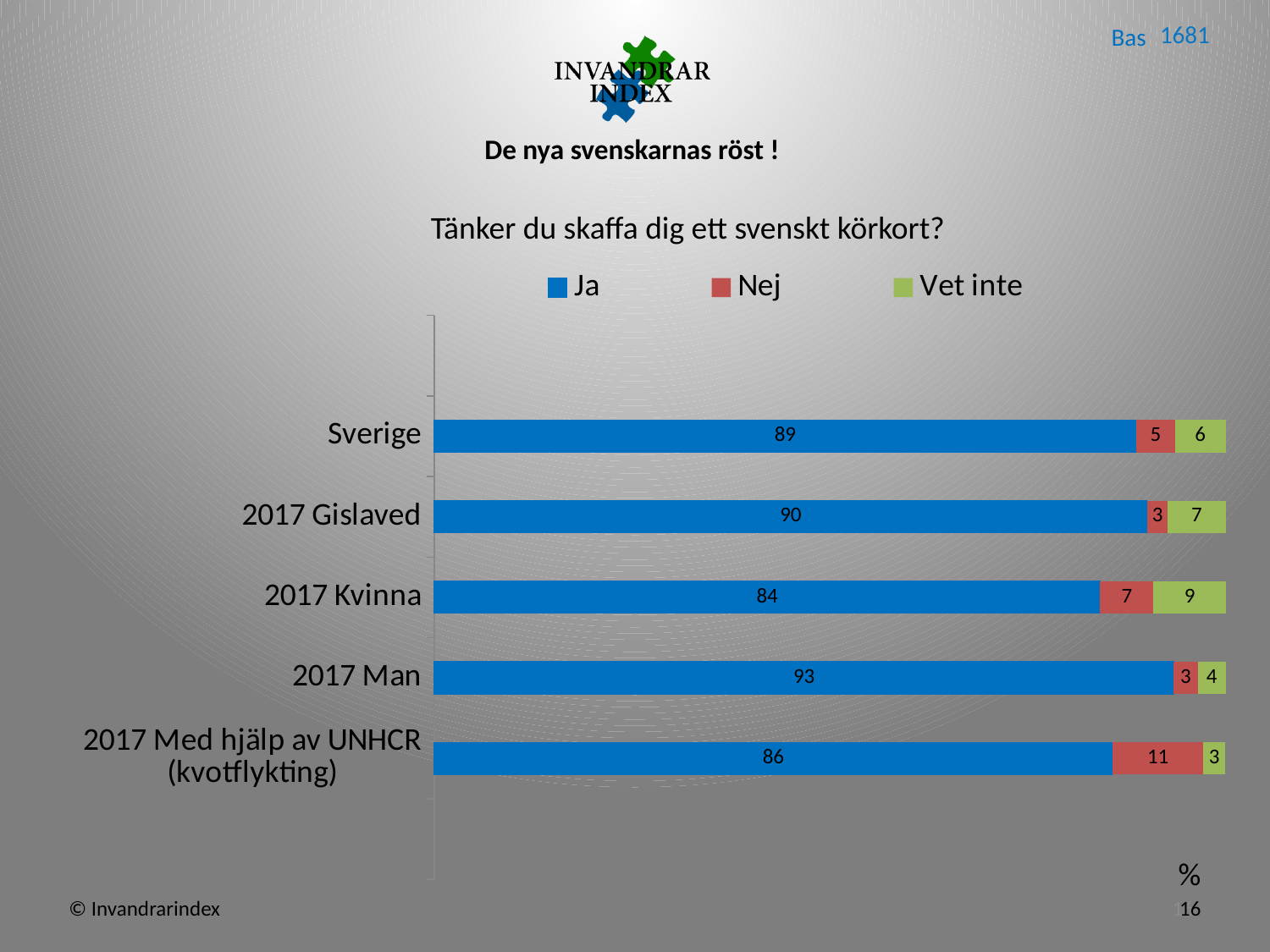
What is the value of "Nej" for 2017 Med hjälp av UNHCR (kvotflykting)? 11 Which category has the lowest "Ja" value? 2017 Kvinna What is the title of the chart? Tänker du skaffa dig ett svenskt körkort? What kind of chart is shown on the slide? Stacked bar chart What is the difference between the "Ja" values for 2017 Man and 2017 Kvinna? 9 What is the value of "Ja" for 2017 Kvinna? 84 Which is larger, the "Nej" value for 2017 Kvinna or for Sverige? 2017 Kvinna What is the value of "Vet inte" for 2017 Gislaved? 7 What is the total of the stacked bar for Sverige? 100 How many categories are shown on the chart? 5 Which category has the highest "Ja" value? 2017 Man How many series does the legend list? 3